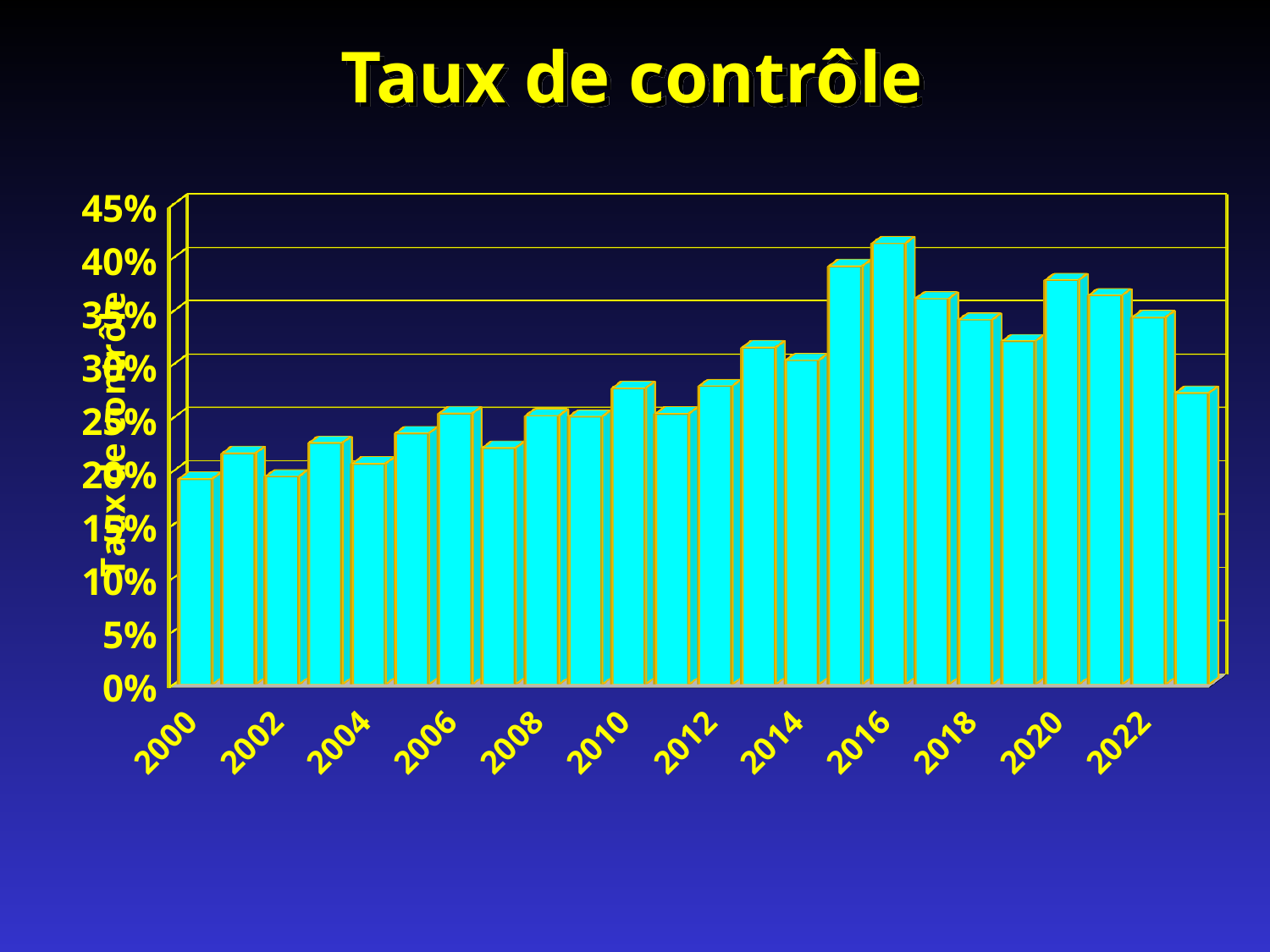
Which is larger, the value for 2000 or the value for 2015? 2015 Is the value for 2006 greater or less than 20%? greater Which year has the highest taux de contrôle? 2016 From 2020 to 2023, do the values generally rise or fall? fall Is the value for 2015 greater or less than 35%? greater How many bars (years) are plotted in the chart? 24 What is the title of the chart? Taux de contrôle Which is larger, the value for 2016 or the value for 2020? 2016 Is the value for 2023 greater or less than 30%? less What kind of chart is shown on the slide? bar chart